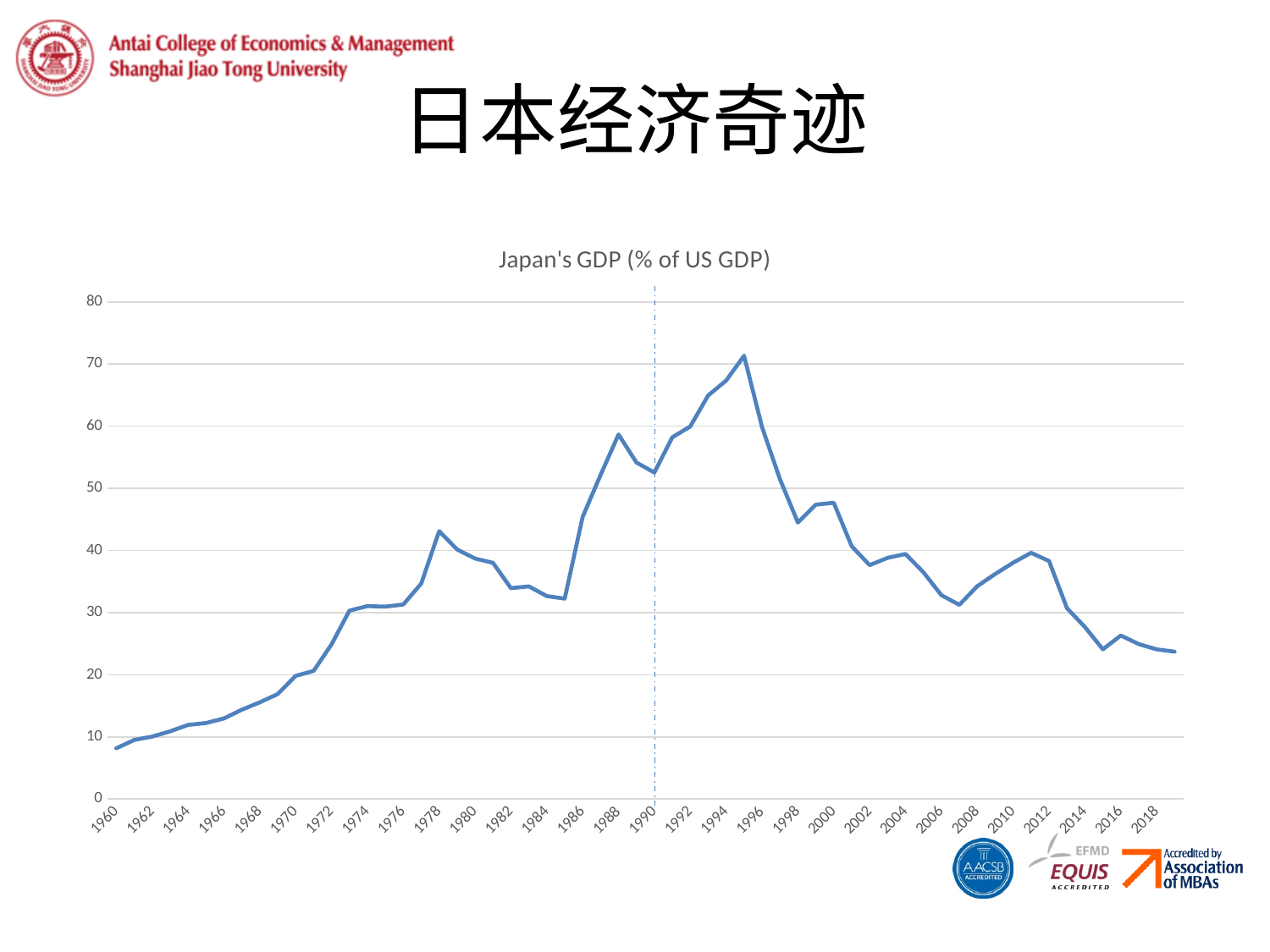
Is the value for 2018 greater or less than 30? less Does the value generally rise or fall between 1995 and 2018? fall Is the value for 1995 greater or less than 60? greater Which year has the larger value, 1978 or 1988? 1988 Is the value for 2000 greater or less than 50? less In which year is Japan's GDP as a percentage of US GDP at its lowest? 1960 What kind of chart is shown on the slide? line chart What is the title of the chart? Japan's GDP (% of US GDP) In which year does Japan's GDP as a percentage of US GDP reach its highest point? 1995 Does the value generally rise or fall between 1960 and 1978? rise